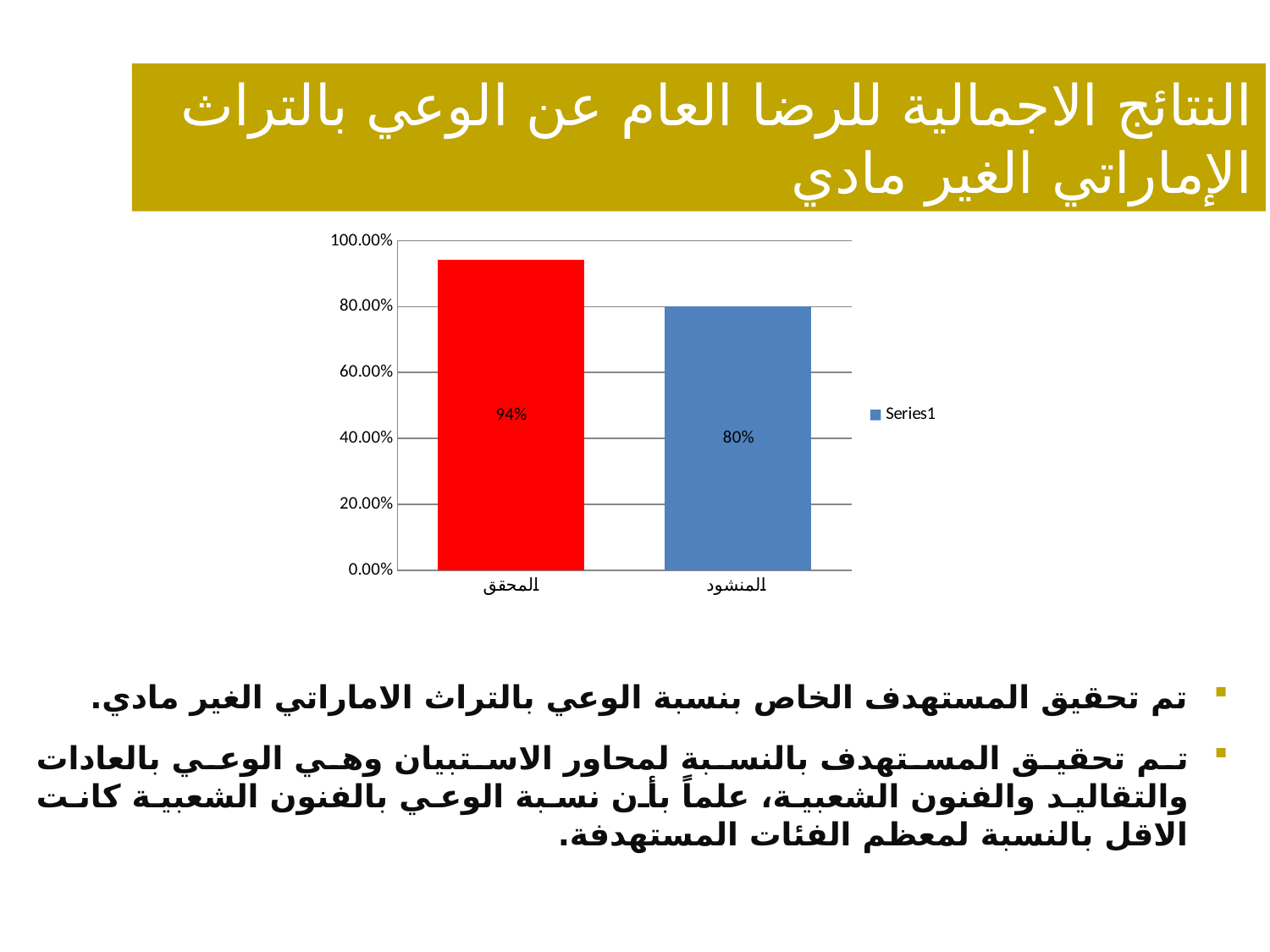
What kind of chart is shown on the slide? bar chart How many series does the legend list? 1 What is the value for المحقق? 94% What is the difference between the values for المحقق and المنشود? 14% What is the value for المنشود? 80% Is the value for المحقق greater or less than 80.00%? greater Which is larger, the value for المحقق or the value for المنشود? المحقق What colour is the bar for المحقق? red What is the name of the series listed in the legend? Series1 Which category has the lowest value? المنشود How many categories are shown on the x axis? 2 Which category has the highest value? المحقق